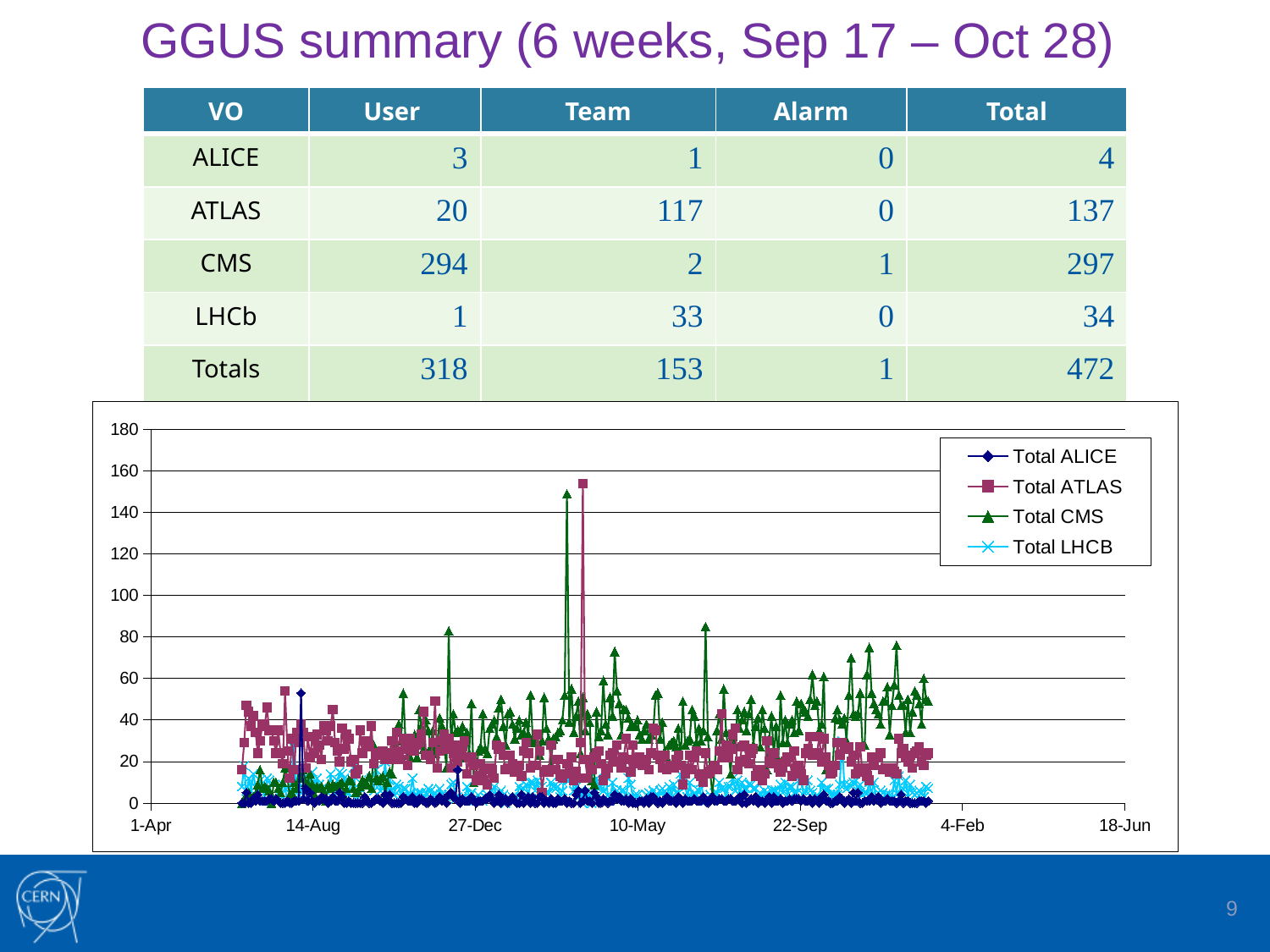
How many series does the chart legend list? 4 What kind of chart is shown on the slide? line chart Which series in the chart stays closest to zero for most of the period? Total ALICE Is the highest value of the Total CMS series greater or less than 120? greater What is the first date label on the x axis of the chart? 1-Apr Is the highest value of the Total ALICE series greater or less than 80? less Is the highest value of the Total ATLAS series greater or less than 140? greater What is the maximum value shown on the y axis of the chart? 180 What colour is the Total CMS series in the chart? green How many date labels are shown on the x axis of the chart? 7 Which series are listed in the chart legend? Total ALICE, Total ATLAS, Total CMS, Total LHCB